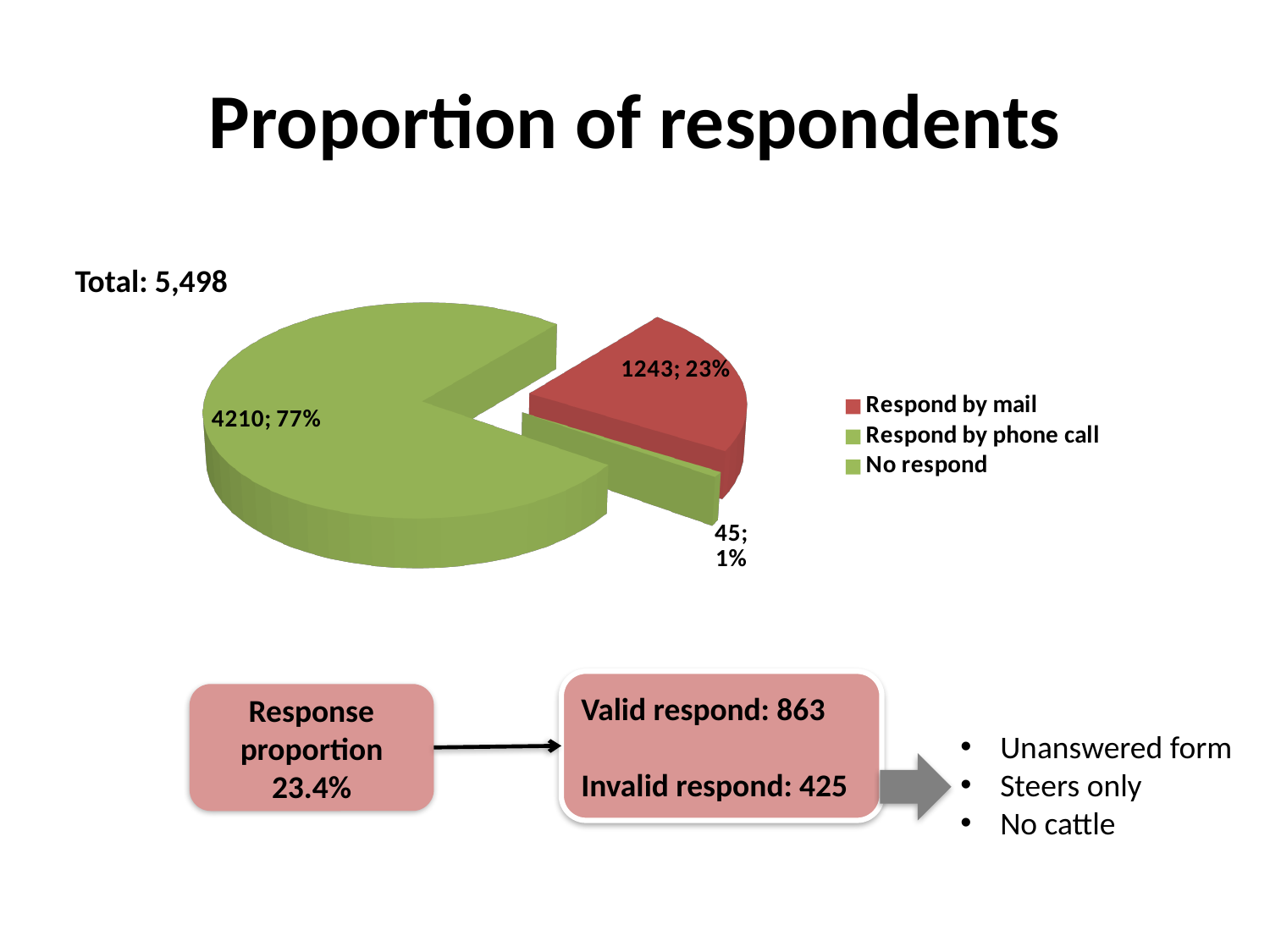
What is the difference between the 'No respond' count and the 'Respond by mail' count? 2967 What is the value shown for the 'Respond by phone call' slice? 45; 1% What kind of chart is shown on the slide? pie chart What total is stated above the pie chart? Total: 5,498 What is the value shown for the 'No respond' slice? 4210; 77% What share of the pie does 'Respond by mail' represent? 23% Which category has the largest slice of the pie? No respond What is the value shown for the 'Respond by mail' slice? 1243; 23% Which category has the smallest slice of the pie? Respond by phone call How many entries does the legend of the pie chart list? 3 Which is larger, the 'Respond by mail' slice or the 'Respond by phone call' slice? Respond by mail How many slices does the pie chart have? 3